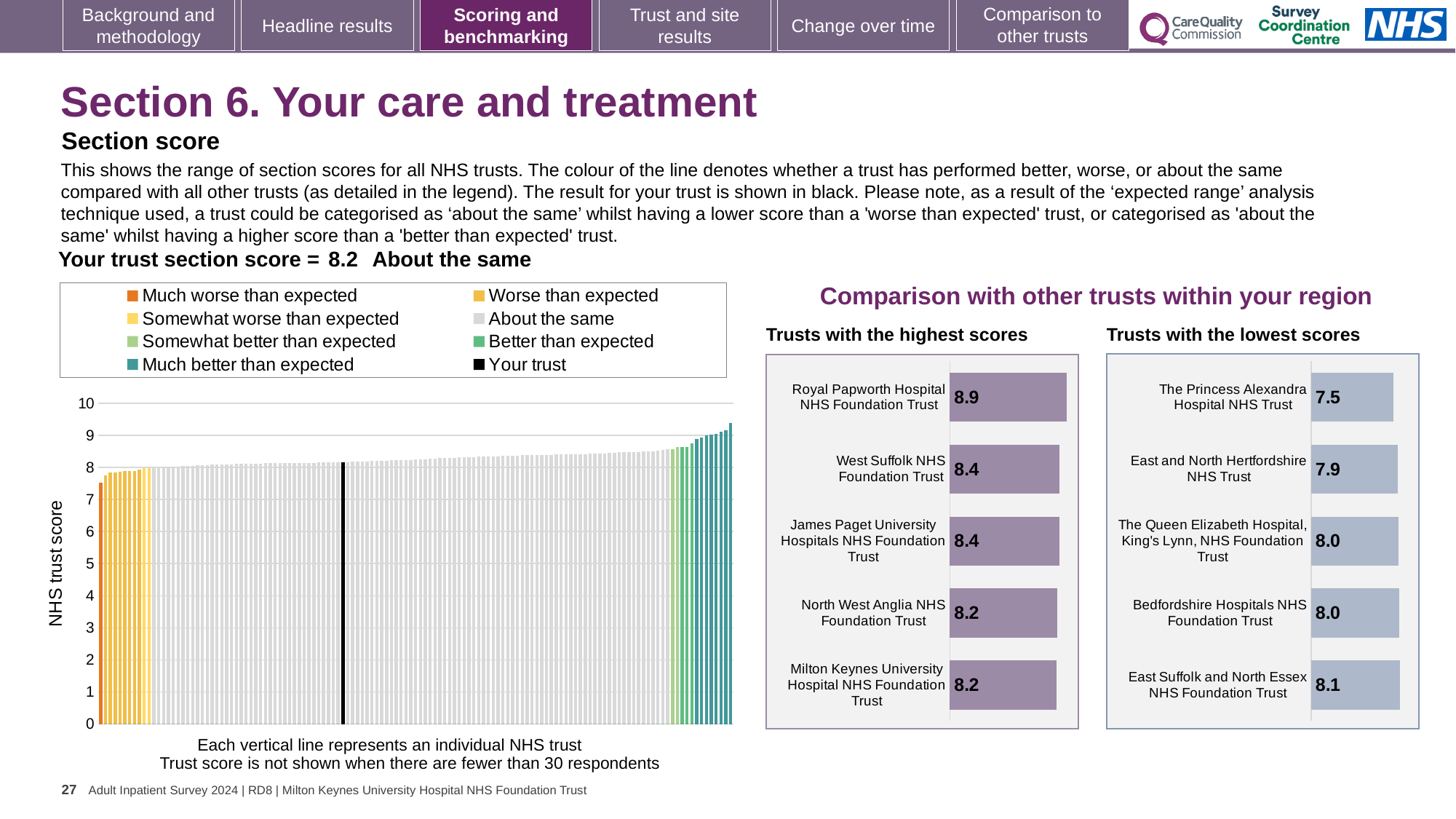
What kind of chart is the 'Trusts with the lowest scores' chart? bar chart In the 'Trusts with the highest scores' chart, which trust has the highest score? Royal Papworth Hospital NHS Foundation Trust How many entries does the legend of the 'NHS trust score' chart list? 8 In the 'NHS trust score' chart, do the trust scores rise or fall from left to right along the x axis? rise In the 'Trusts with the highest scores' chart, which has the larger score: West Suffolk NHS Foundation Trust or North West Anglia NHS Foundation Trust? West Suffolk NHS Foundation Trust In the 'Trusts with the lowest scores' chart, which trust has the lowest score? The Princess Alexandra Hospital NHS Trust In the 'Trusts with the highest scores' chart, what is the score for Royal Papworth Hospital NHS Foundation Trust? 8.9 In the 'Trusts with the highest scores' chart, what is the score for Milton Keynes University Hospital NHS Foundation Trust? 8.2 How many trusts are shown in the 'Trusts with the highest scores' chart? 5 In the 'Trusts with the highest scores' chart, what is the difference between the scores of Royal Papworth Hospital NHS Foundation Trust and West Suffolk NHS Foundation Trust? 0.5 In the 'Trusts with the lowest scores' chart, how much higher is East Suffolk and North Essex NHS Foundation Trust's score than The Princess Alexandra Hospital NHS Trust's score? 0.6 In the 'Trusts with the lowest scores' chart, what is the score for The Princess Alexandra Hospital NHS Trust? 7.5